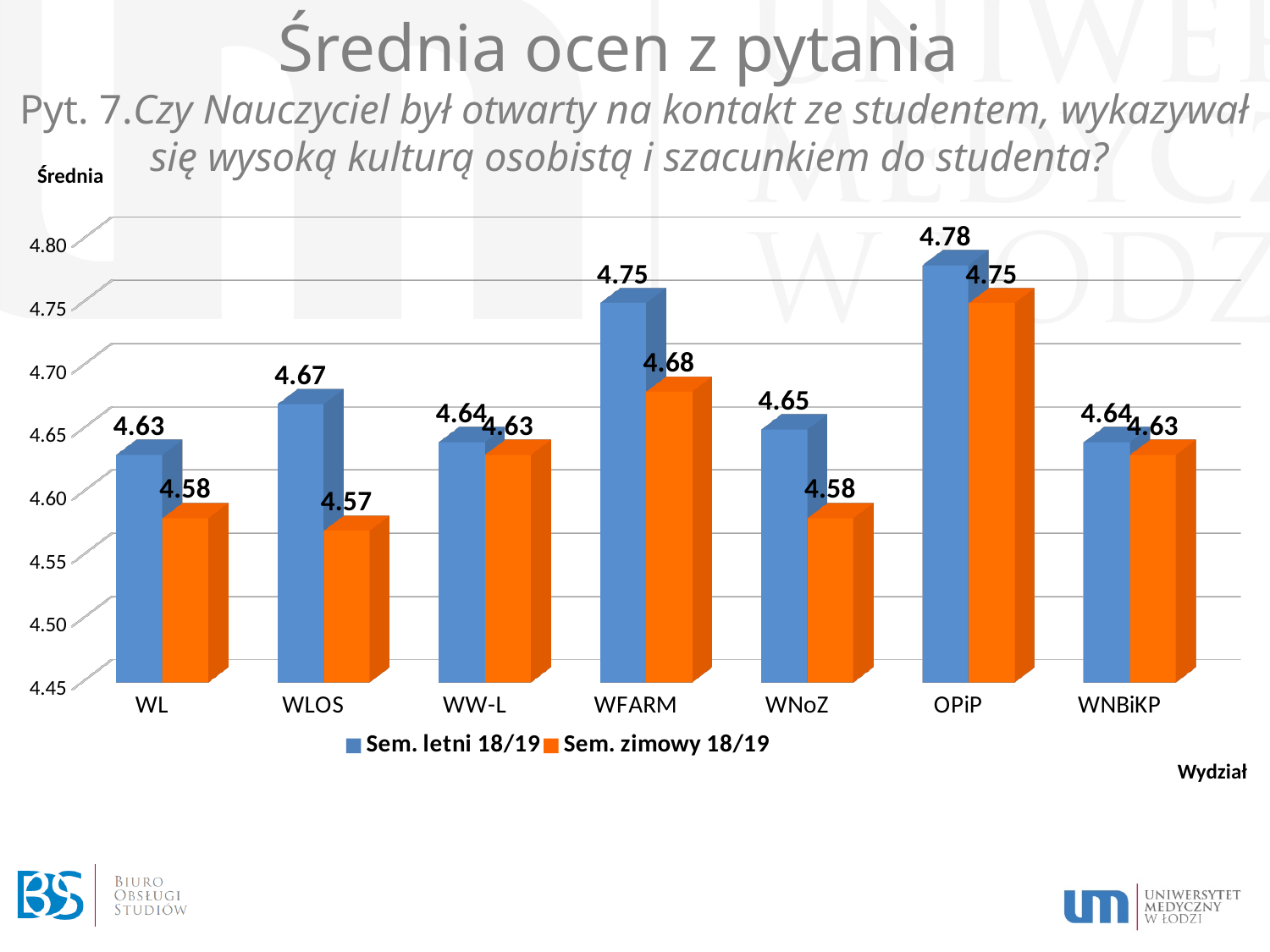
What kind of chart is shown on the slide? bar chart Which colour represents the Sem. zimowy 18/19 series? orange What is the value for WLOS in the Sem. zimowy 18/19 series? 4.57 Is the Sem. zimowy 18/19 value for WNoZ greater or less than 4.60? less Which category has the highest value in the Sem. letni 18/19 series? OPiP How many categories (wydziały) are shown on the x axis? 7 What is the value for OPiP in the Sem. letni 18/19 series? 4.78 Which is larger for WFARM: the Sem. letni 18/19 value or the Sem. zimowy 18/19 value? Sem. letni 18/19 How many series does the legend list? 2 Which category has the lowest value in the Sem. zimowy 18/19 series? WLOS What is the value for WFARM in the Sem. zimowy 18/19 series? 4.68 What is the difference between the Sem. letni 18/19 and Sem. zimowy 18/19 values for WLOS? 0.10